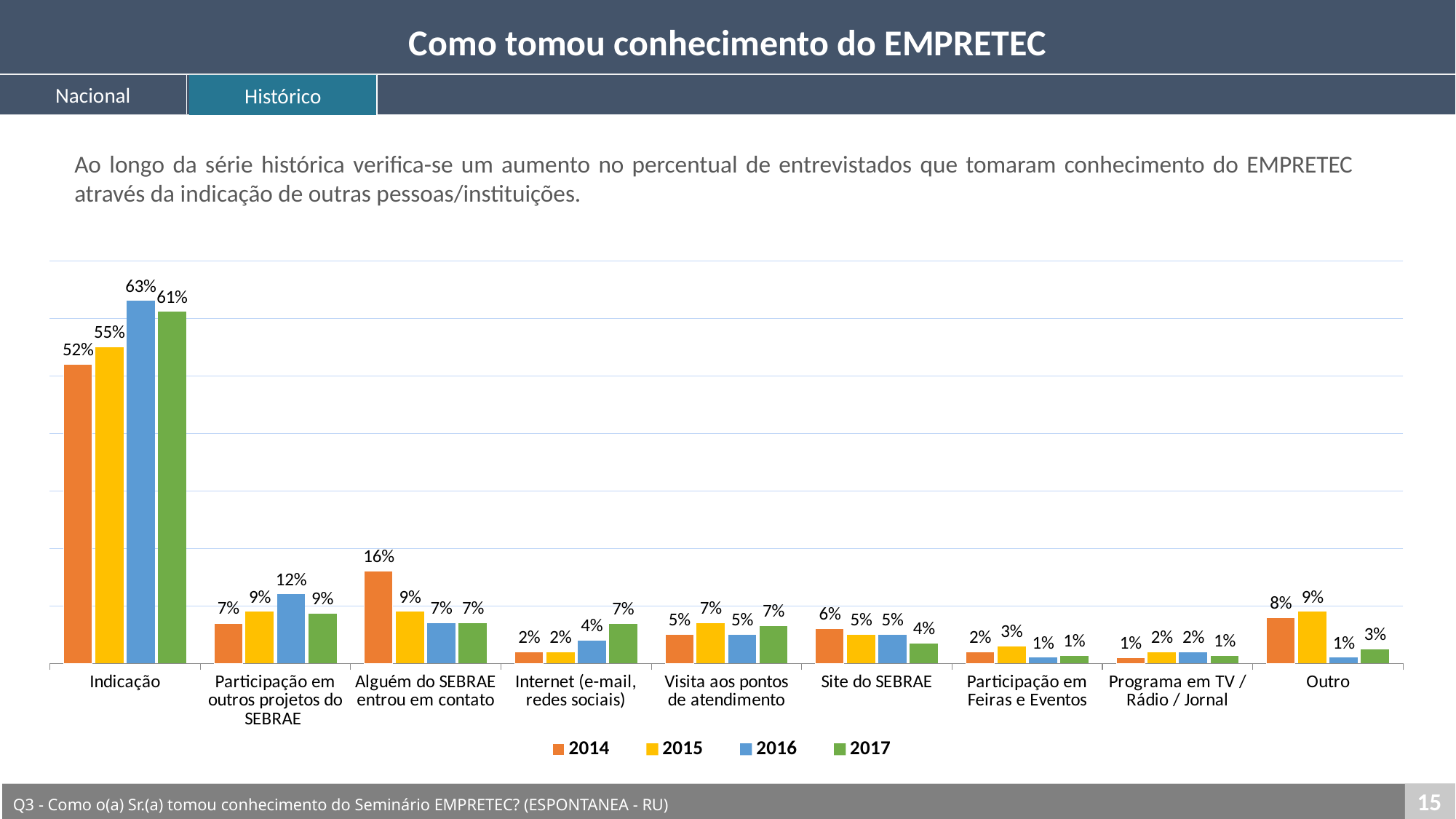
What is the value for Internet (e-mail, redes sociais) in 2017? 7% Which category has the lowest value in 2014? Programa em TV / Rádio / Jornal Do the values for Indicação rise or fall from 2014 to 2016? rise Which colour represents the 2015 series in the legend? yellow Which category has the highest value in 2017? Indicação What is the value for Alguém do SEBRAE entrou em contato in 2014? 16% How many categories are shown on the x axis? 9 What kind of chart is shown on the slide? bar chart What is the difference between the 2016 and 2014 values for Indicação? 11% Which is larger for Participação em outros projetos do SEBRAE: the 2016 value or the 2017 value? 2016 How many series does the legend list? 4 What is the value for Indicação in 2016? 63%